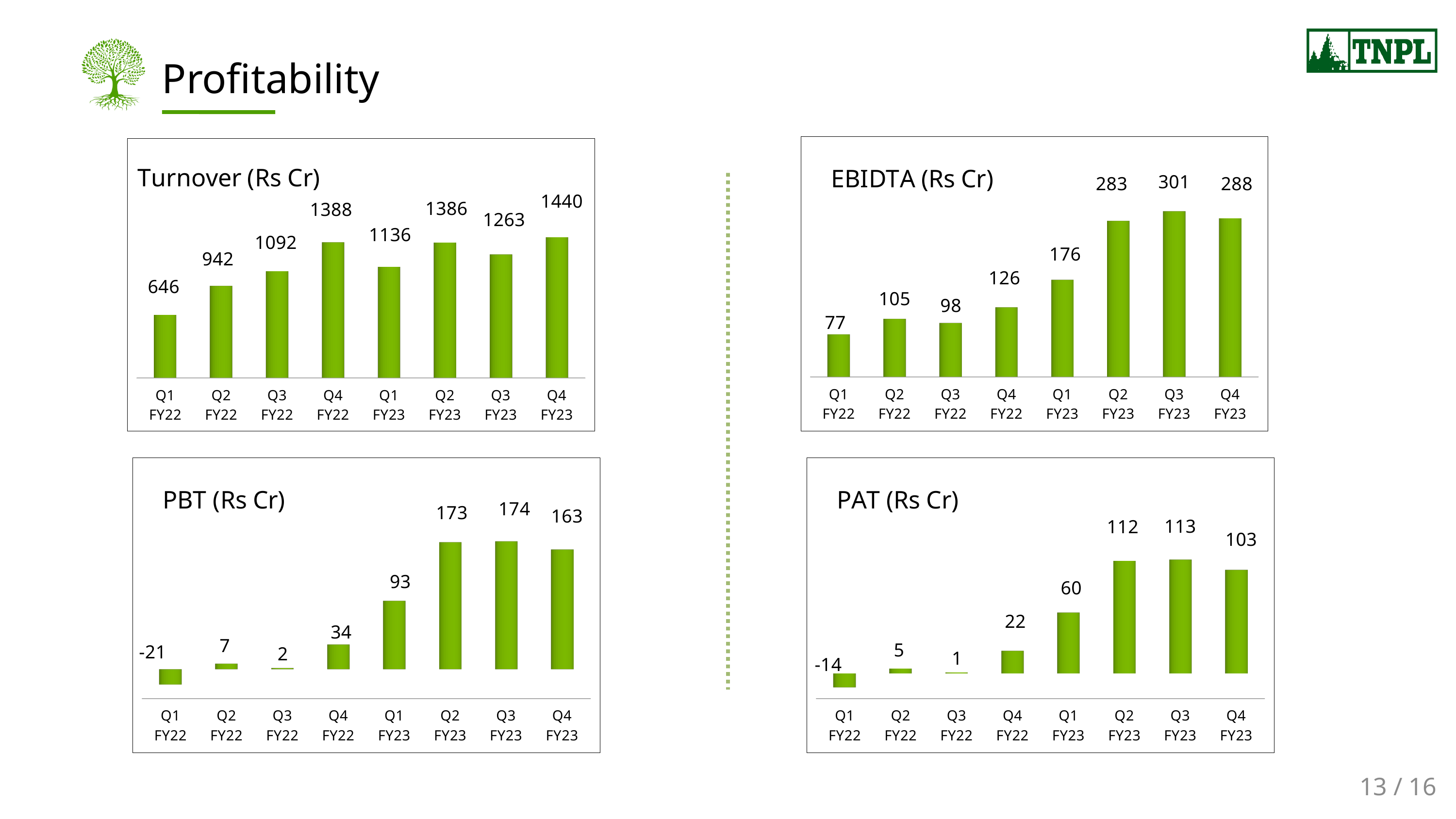
In the PBT (Rs Cr) chart, which quarter has the highest PBT? Q3 FY23 In the Turnover (Rs Cr) chart, what is the difference between Q4 FY22 and Q1 FY23? 252 In the PAT (Rs Cr) chart, how many quarters are plotted? 8 In the PBT (Rs Cr) chart, what is the value for Q1 FY22? -21 In the Turnover (Rs Cr) chart, which quarter has the lowest turnover? Q1 FY22 In the PAT (Rs Cr) chart, what is the value for Q4 FY22? 22 What kind of chart is the PAT (Rs Cr) chart? Bar chart In the Turnover (Rs Cr) chart, what is the value for Q4 FY23? 1440 In the PBT (Rs Cr) chart, what is the difference between Q2 FY23 and Q4 FY23? 10 In the EBIDTA (Rs Cr) chart, which is larger, Q2 FY22 or Q3 FY22? Q2 FY22 In the EBIDTA (Rs Cr) chart, what is the value for Q1 FY23? 176 In the EBIDTA (Rs Cr) chart, which quarter has the highest EBIDTA? Q3 FY23